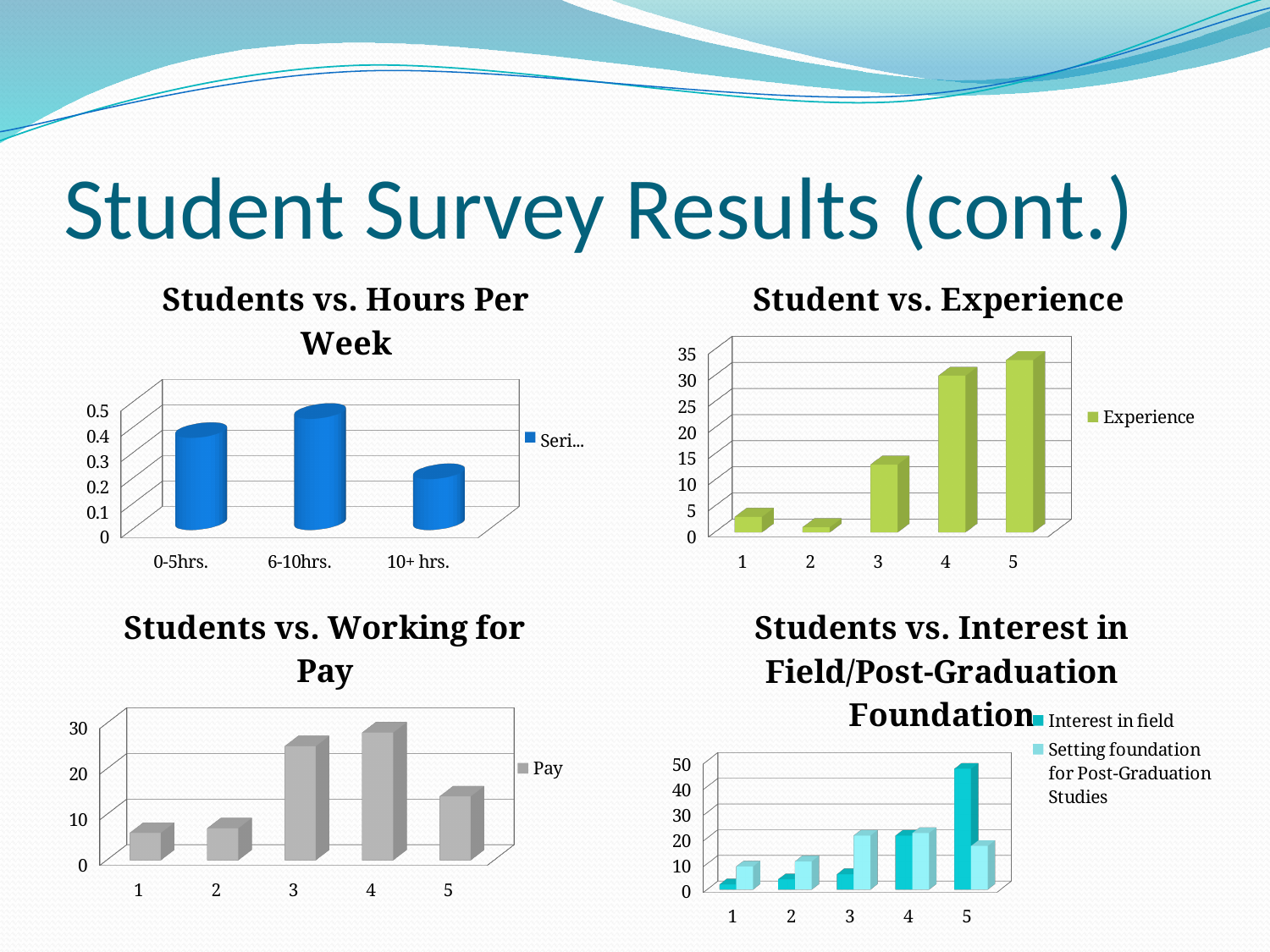
In the 'Student vs. Experience' chart, which category has the lowest value? 2 In the 'Student vs. Experience' chart, which category has the highest value? 5 In the 'Students vs. Interest in Field/Post-Graduation Foundation' chart, is the 'Interest in field' value for category 5 greater or less than 40? greater How many series does the legend list in the 'Students vs. Interest in Field/Post-Graduation Foundation' chart? 2 In the 'Students vs. Hours Per Week' chart, which category has the lowest value? 10+ hrs. What kind of chart is the 'Student vs. Experience' chart? bar chart In the 'Student vs. Experience' chart, is the value for category 4 greater or less than 25? greater In the 'Students vs. Working for Pay' chart, which category has the highest value? 4 How many categories are shown in the 'Students vs. Hours Per Week' chart? 3 In the 'Students vs. Working for Pay' chart, is the value for category 3 greater or less than 20? greater In the 'Students vs. Working for Pay' chart, which is larger, the value for category 5 or the value for category 1? category 5 In the 'Students vs. Hours Per Week' chart, which category has the highest value? 6-10hrs.